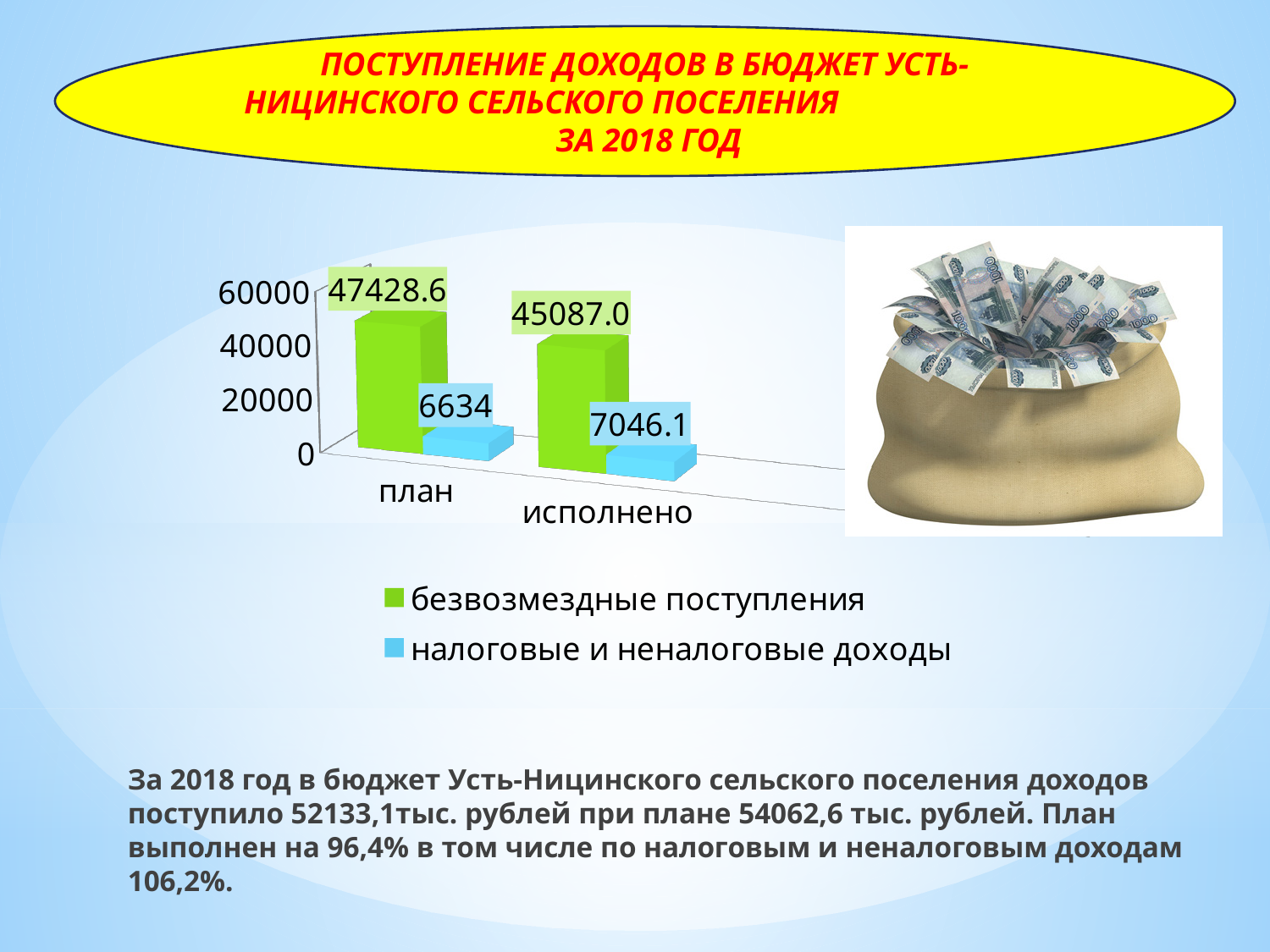
What is the difference between the план and исполнено values for безвозмездные поступления? 2341.6 What kind of chart is shown on the slide? bar chart What is the value of безвозмездные поступления for исполнено? 45087.0 Which category has the higher value for налоговые и неналоговые доходы, план or исполнено? исполнено Which category has the higher value for безвозмездные поступления, план or исполнено? план What is the value of налоговые и неналоговые доходы for исполнено? 7046.1 How many categories are shown on the x axis of the chart? 2 What is the difference between the исполнено and план values for налоговые и неналоговые доходы? 412.1 How many series does the chart legend list? 2 What is the value of безвозмездные поступления for план? 47428.6 What is the value of налоговые и неналоговые доходы for план? 6634 Is the value of безвозмездные поступления for исполнено greater or less than 40000? greater